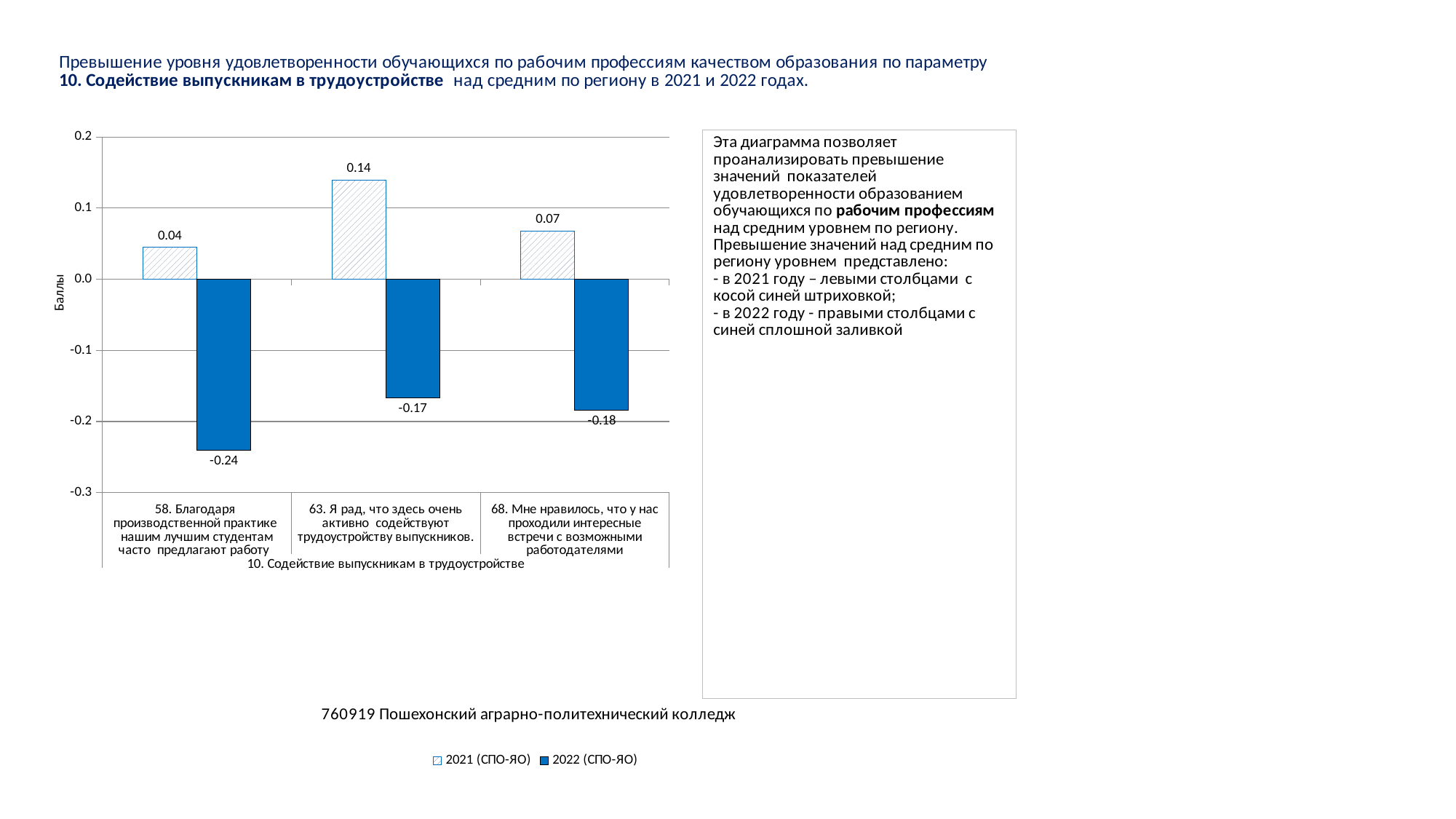
What is the label of the vertical axis of the chart? Баллы Which is larger for category 58: the 2021 (СПО-ЯО) value or the 2022 (СПО-ЯО) value? 2021 (СПО-ЯО) How many categories are shown on the x axis of the chart? 3 What is the value for 2021 (СПО-ЯО) for category 63 (Я рад, что здесь очень активно содействуют трудоустройству выпускников)? 0.14 What is the difference between the 2021 (СПО-ЯО) and 2022 (СПО-ЯО) values for category 63? 0.31 Which category has the highest value for the 2021 (СПО-ЯО) series? 63. Я рад, что здесь очень активно содействуют трудоустройству выпускников. What is the value for 2022 (СПО-ЯО) for category 58 (Благодаря производственной практике нашим лучшим студентам часто предлагают работу)? -0.24 Which category has the lowest value for the 2022 (СПО-ЯО) series? 58. Благодаря производственной практике нашим лучшим студентам часто предлагают работу How many series does the chart legend list? 2 Is the 2022 (СПО-ЯО) value for category 58 greater or less than -0.2? less What is the value for 2022 (СПО-ЯО) for category 68 (Мне нравилось, что у нас проходили интересные встречи с возможными работодателями)? -0.18 What kind of chart is shown on the slide? bar chart